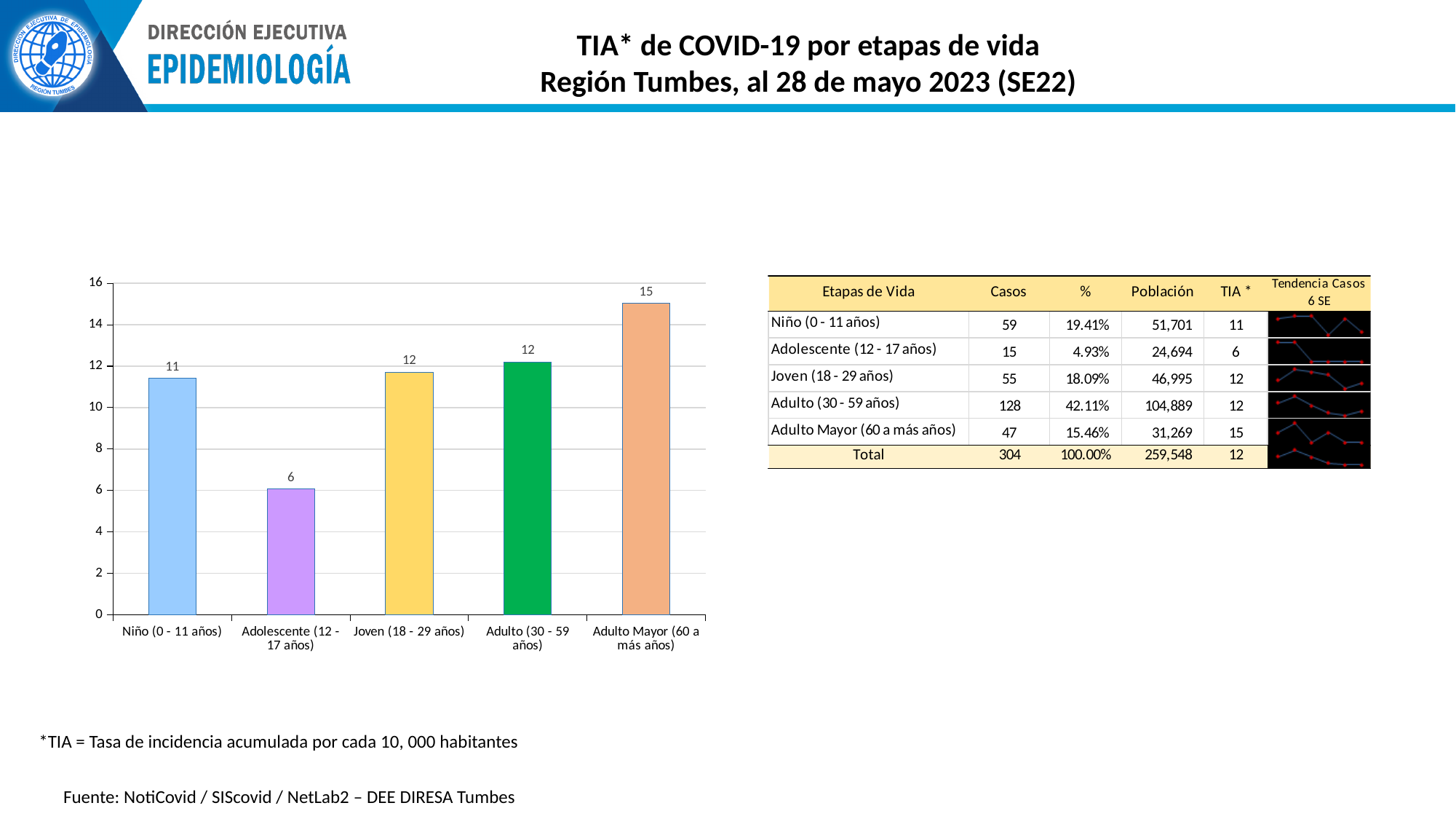
What is the value shown for Adulto Mayor (60 a más años) in the bar chart? 15 Which category has the lowest value in the bar chart? Adolescente (12 - 17 años) Which category has the highest value in the bar chart? Adulto Mayor (60 a más años) What kind of chart is shown on the slide? bar chart How many categories are shown on the x axis of the bar chart? 5 What is the difference between the values for Adulto Mayor (60 a más años) and Adolescente (12 - 17 años) in the bar chart? 9 Which is larger in the bar chart, the value for Niño (0 - 11 años) or the value for Adulto Mayor (60 a más años)? Adulto Mayor (60 a más años) What is the value shown for Joven (18 - 29 años) in the bar chart? 12 Is the value for Adolescente (12 - 17 años) in the bar chart greater or less than 8? less What is the maximum value shown on the y axis of the bar chart? 16 What is the value shown for Niño (0 - 11 años) in the bar chart? 11 What is the value shown for Adolescente (12 - 17 años) in the bar chart? 6